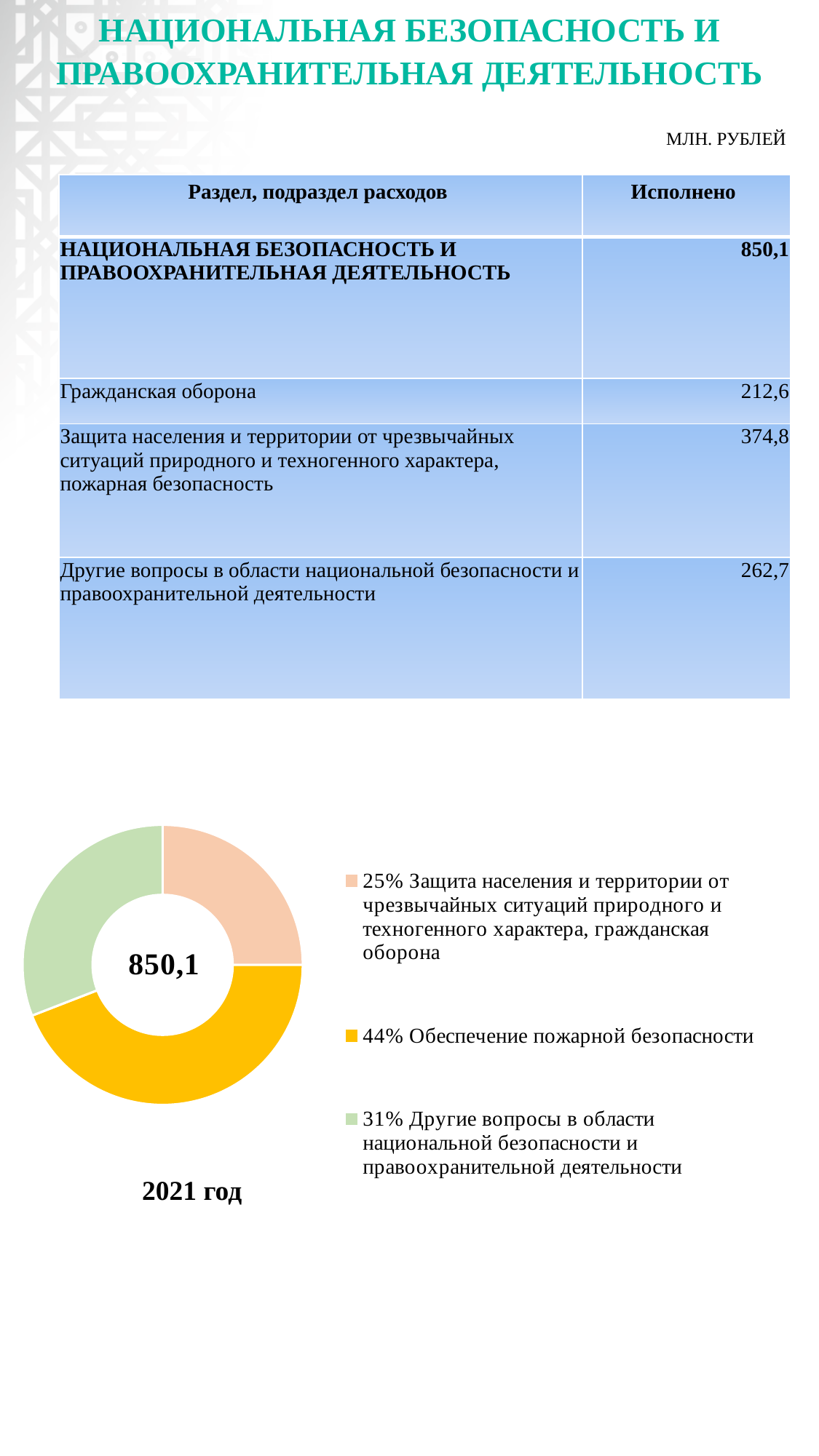
Which category has the smallest slice in the doughnut chart? Защита населения и территории от чрезвычайных ситуаций природного и техногенного характера, гражданская оборона What share of the doughnut chart does "Другие вопросы в области национальной безопасности и правоохранительной деятельности" take? 31% What kind of chart is shown at the bottom of the slide? Doughnut (pie) chart What share of the doughnut chart does "Обеспечение пожарной безопасности" take? 44% How many entries does the legend of the doughnut chart list? 3 Which category has the largest slice in the doughnut chart? Обеспечение пожарной безопасности How many slices does the doughnut chart have? 3 In the doughnut chart, which is larger: the share for "Обеспечение пожарной безопасности" or the share for "Другие вопросы в области национальной безопасности и правоохранительной деятельности"? Обеспечение пожарной безопасности What share of the doughnut chart does "Защита населения и территории от чрезвычайных ситуаций природного и техногенного характера, гражданская оборона" take? 25% What total value is printed in the centre of the doughnut chart? 850,1 By how many percentage points does the share for "Обеспечение пожарной безопасности" exceed the share for "Защита населения и территории от чрезвычайных ситуаций природного и техногенного характера, гражданская оборона" in the doughnut chart? 19 percentage points What year label is shown beneath the doughnut chart? 2021 год